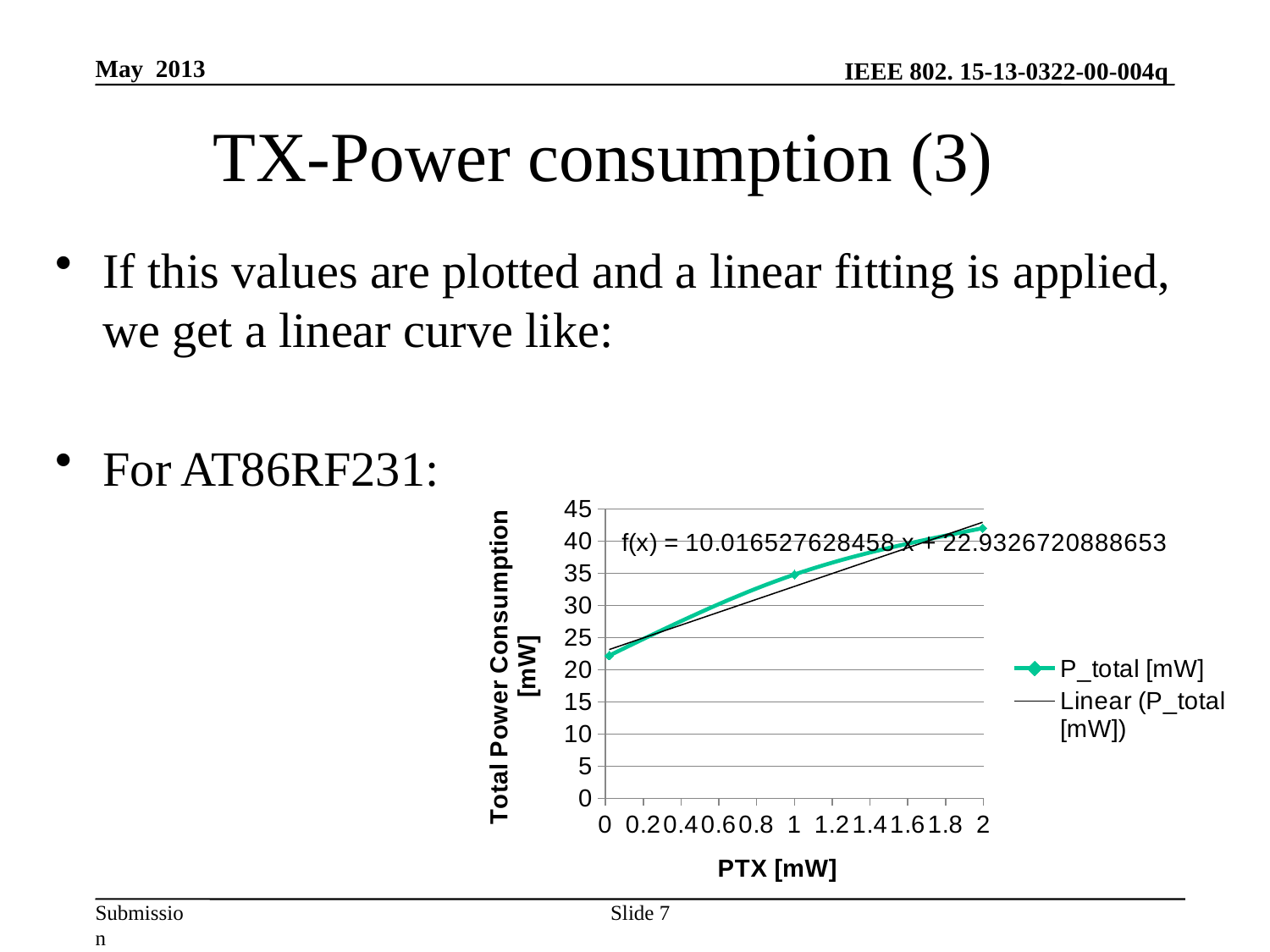
How many data points are plotted for the P_total [mW] series? 3 What kind of chart is shown on the slide? line chart What is the equation of the linear fit shown on the chart? f(x) = 10.016527628458 x + 22.9326720888653 Does the P_total [mW] value rise or fall as PTX [mW] increases? rise Is the P_total [mW] value at PTX = 2 mW greater or less than 40? greater Which is larger, the P_total [mW] value at PTX = 1 mW or at PTX = 2 mW? PTX = 2 mW Is the P_total [mW] value at PTX = 0 mW greater or less than 25? less Is the P_total [mW] value at PTX = 1 mW greater or less than 30? greater How many entries does the legend list? 2 At which PTX value is the P_total [mW] highest? 2 What is the title of the y axis? Total Power Consumption [mW] At which PTX value is the P_total [mW] lowest? 0